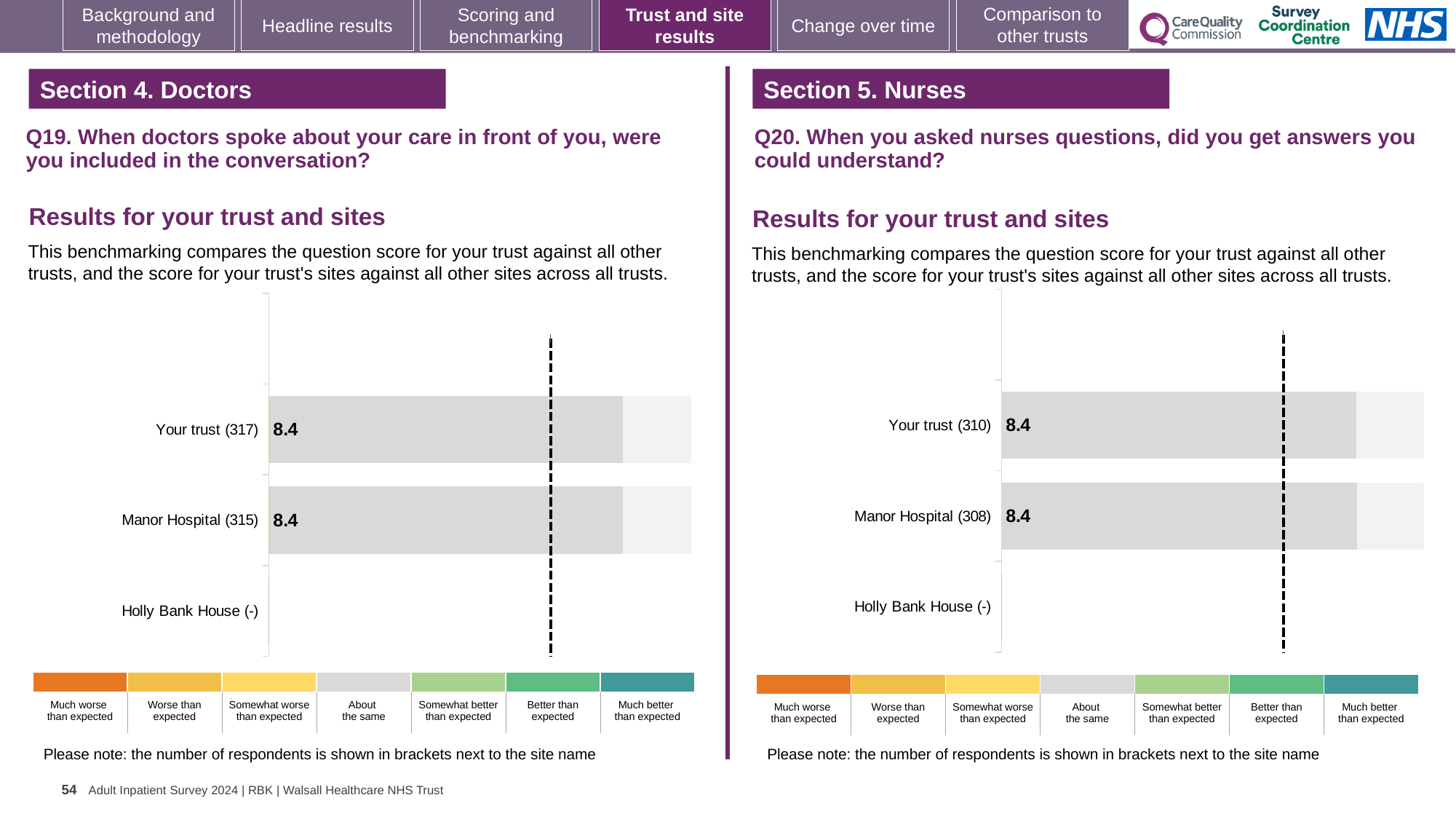
On the Q20 chart (Section 5. Nurses), how many sites or categories are listed on the vertical axis? 3 On the Q19 chart (Section 4. Doctors), what is the score for Your trust? 8.4 On the Q19 chart (Section 4. Doctors), what is the difference between the scores for Your trust and Manor Hospital? 0 On the Q19 chart (Section 4. Doctors), how many respondents are shown in brackets for Manor Hospital? 315 On the Q19 chart (Section 4. Doctors), how many respondents are shown in brackets for Your trust? 317 On the Q20 chart (Section 5. Nurses), how many respondents are shown in brackets for Manor Hospital? 308 On the Q20 chart (Section 5. Nurses), how many respondents are shown in brackets for Your trust? 310 On the Q20 chart (Section 5. Nurses), what is the score for Manor Hospital? 8.4 What kind of chart is used on the Q19 chart (Section 4. Doctors)? Bar chart On the Q19 chart (Section 4. Doctors), which category has no score shown? Holly Bank House On the Q19 chart (Section 4. Doctors), what is the score for Manor Hospital? 8.4 On the Q20 chart (Section 5. Nurses), what is the score for Your trust? 8.4